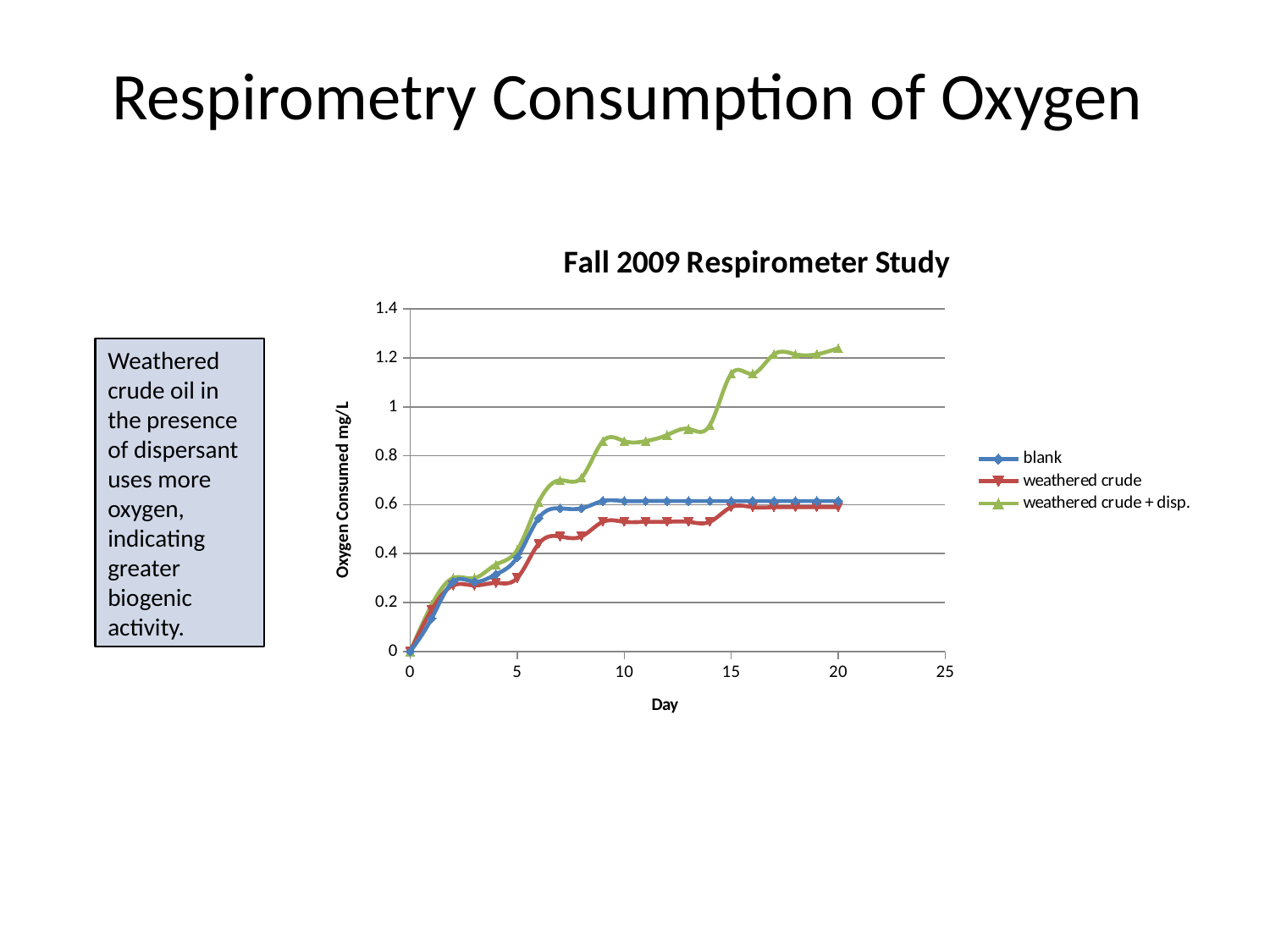
At day 7, which is larger: the value for blank or the value for weathered crude? blank Is the value for blank at day 10 greater or less than 0.8? less What is the title of the chart? Fall 2009 Respirometer Study What kind of chart is shown on the slide? line chart Do the values for weathered crude + disp. generally rise or fall from day 0 to day 20? rise What is the label of the y axis? Oxygen Consumed mg/L Is the value for weathered crude + disp. at day 15 greater or less than 1? greater Is the value for weathered crude at day 10 greater or less than 0.6? less How many series does the legend list? 3 Which series has the highest value at day 20? weathered crude + disp. What is the value for the blank series at day 0? 0 Which series has the lowest value at day 10? weathered crude